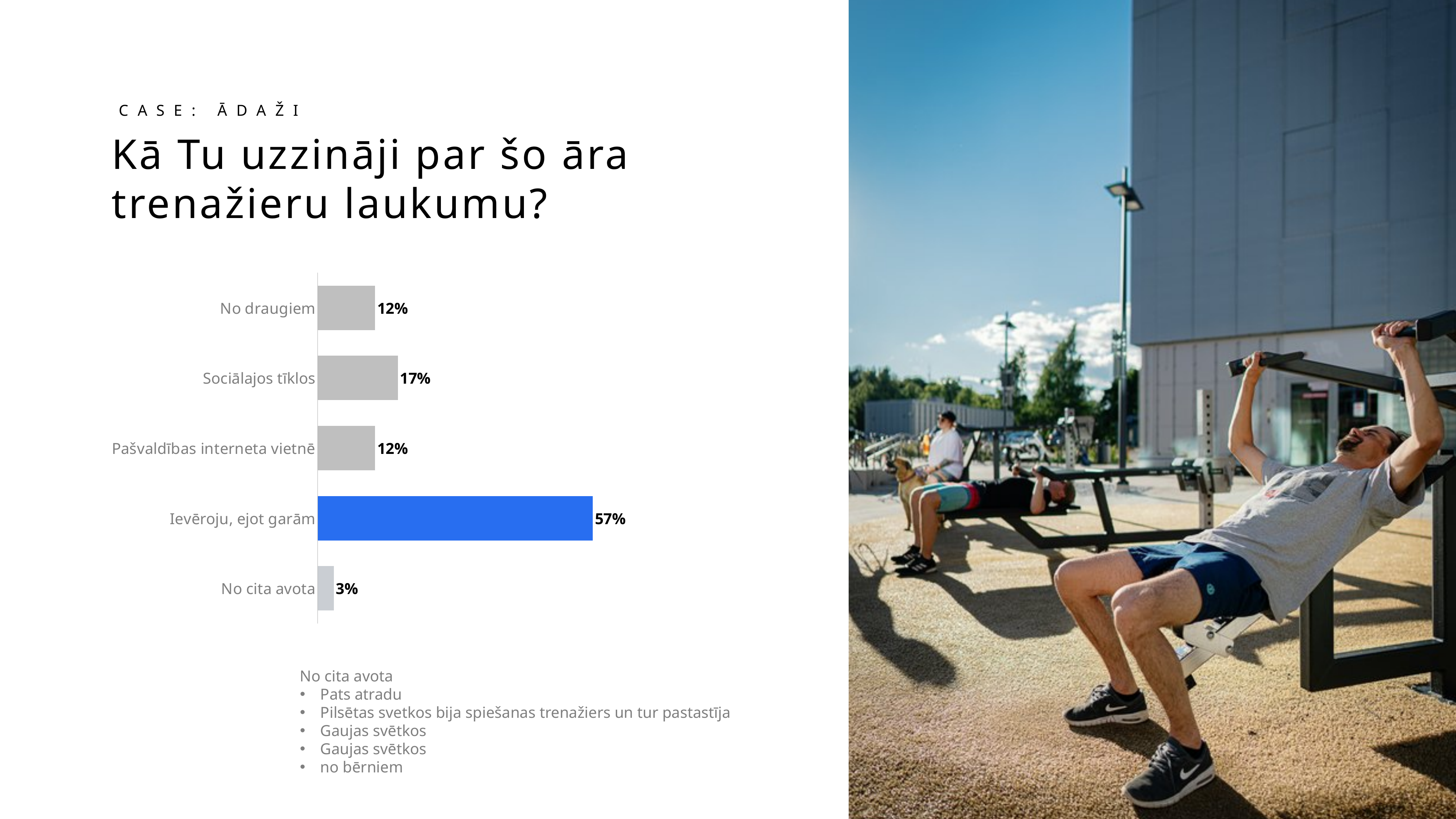
Which bar is highlighted in blue? Ievēroju, ejot garām What kind of chart is shown on the slide? Bar chart How many categories does the chart show? 5 What is the difference between Ievēroju, ejot garām and Sociālajos tīklos? 40% What percentage of respondents learned about the outdoor gym from friends (No draugiem)? 12% What is the value for Sociālajos tīklos? 17% What is the difference between Sociālajos tīklos and No cita avota? 14% What is the value for No cita avota? 3% Which is larger, Sociālajos tīklos or Pašvaldības interneta vietnē? Sociālajos tīklos What is the value for Ievēroju, ejot garām? 57% Which category has the lowest value? No cita avota Which category has the highest value? Ievēroju, ejot garām